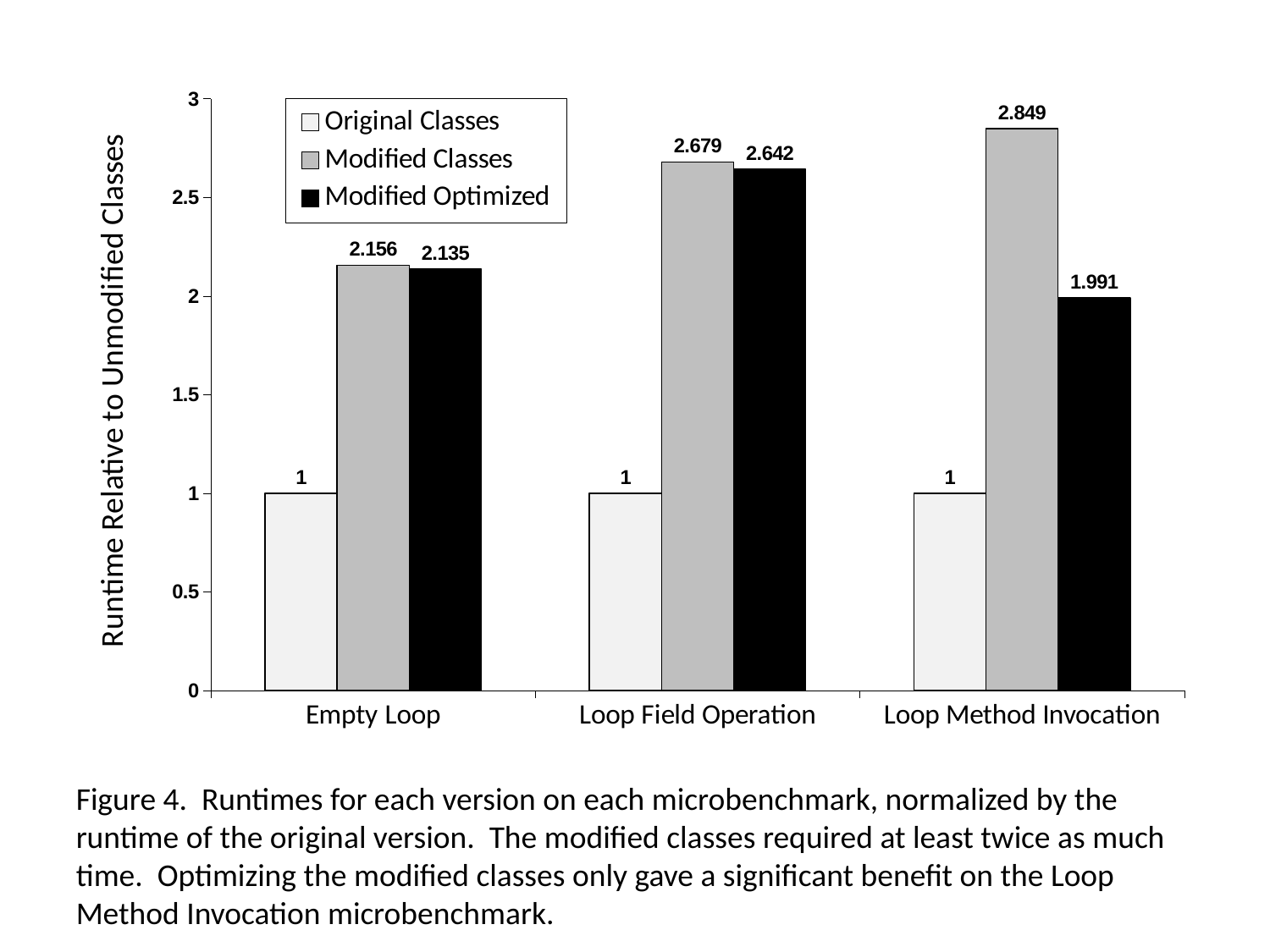
What is the difference between the Modified Classes and Modified Optimized values for Loop Method Invocation? 0.858 Which microbenchmark has the lowest value for Modified Optimized? Loop Method Invocation What is the label of the y axis? Runtime Relative to Unmodified Classes What is the value for Modified Optimized on the Empty Loop microbenchmark? 2.135 Which is larger for Loop Field Operation: the Modified Classes value or the Modified Optimized value? Modified Classes What is the value for Modified Classes on the Loop Method Invocation microbenchmark? 2.849 How many series does the legend list? 3 Is the value for Modified Optimized on Loop Method Invocation greater or less than 2? less What kind of chart is shown on the slide? Bar chart What is the value for Original Classes on the Loop Field Operation microbenchmark? 1 How many microbenchmarks are shown on the x axis? 3 Which microbenchmark has the highest value for Modified Classes? Loop Method Invocation